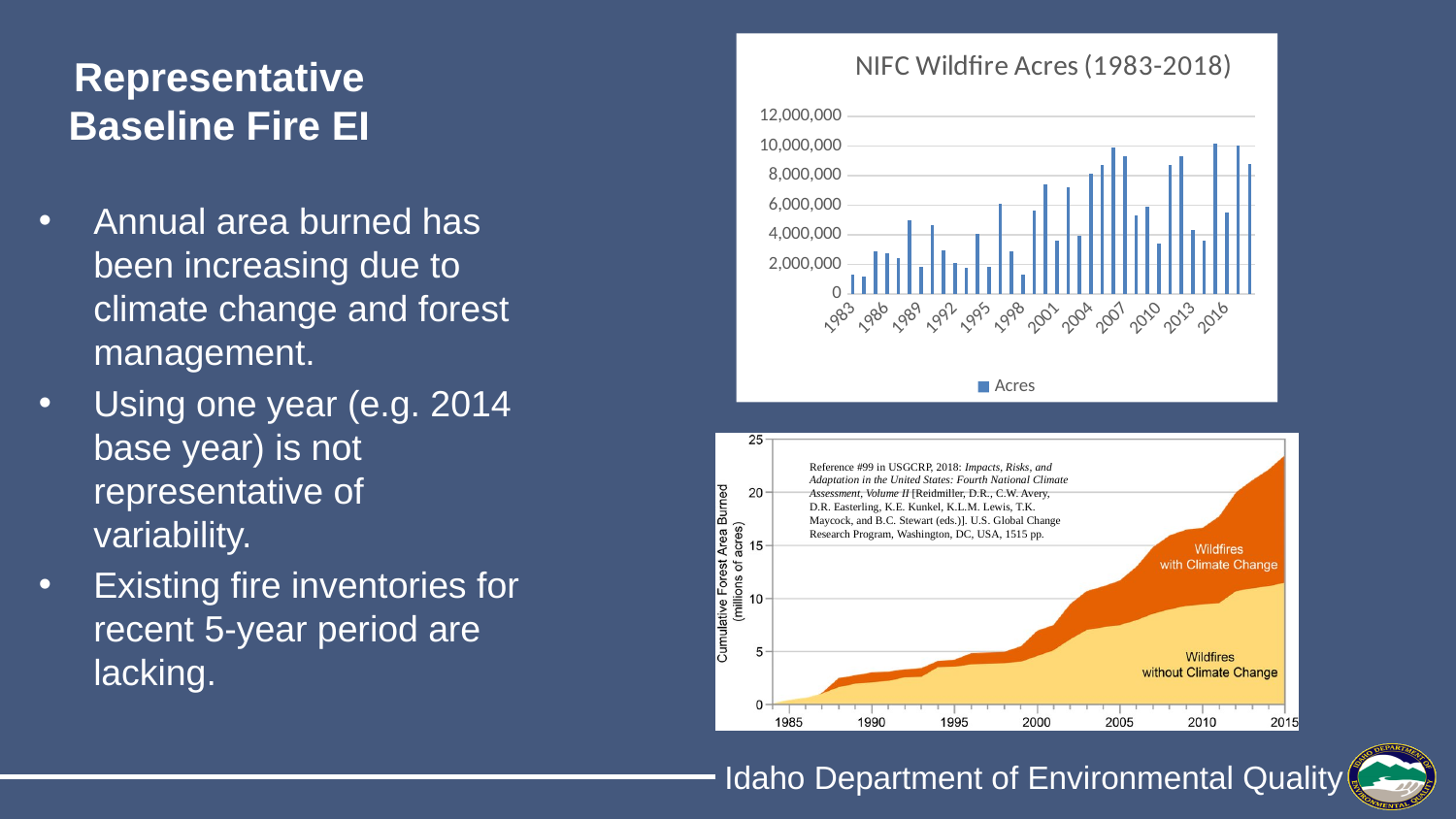
In the NIFC Wildfire Acres (1983-2018) chart, what is the legend entry? Acres What kind of chart is the NIFC Wildfire Acres (1983-2018) chart? bar chart In the NIFC Wildfire Acres (1983-2018) chart, is the value for 1983 greater or less than 2,000,000? less In the Cumulative Forest Area Burned chart, is the value for Wildfires with Climate Change in 2015 greater or less than 20 million acres? greater In the NIFC Wildfire Acres (1983-2018) chart, is the value for 2010 greater or less than 4,000,000? less In the NIFC Wildfire Acres (1983-2018) chart, do the values generally rise or fall from 1983 to 2018? rise In the NIFC Wildfire Acres (1983-2018) chart, how many years (bars) are plotted? 36 In the NIFC Wildfire Acres (1983-2018) chart, how many series does the legend list? 1 What is the title of the bar chart at the top right of the slide? NIFC Wildfire Acres (1983-2018) In the NIFC Wildfire Acres (1983-2018) chart, which year has the lowest value? 1984 What kind of chart is the Cumulative Forest Area Burned chart at the bottom right of the slide? area chart